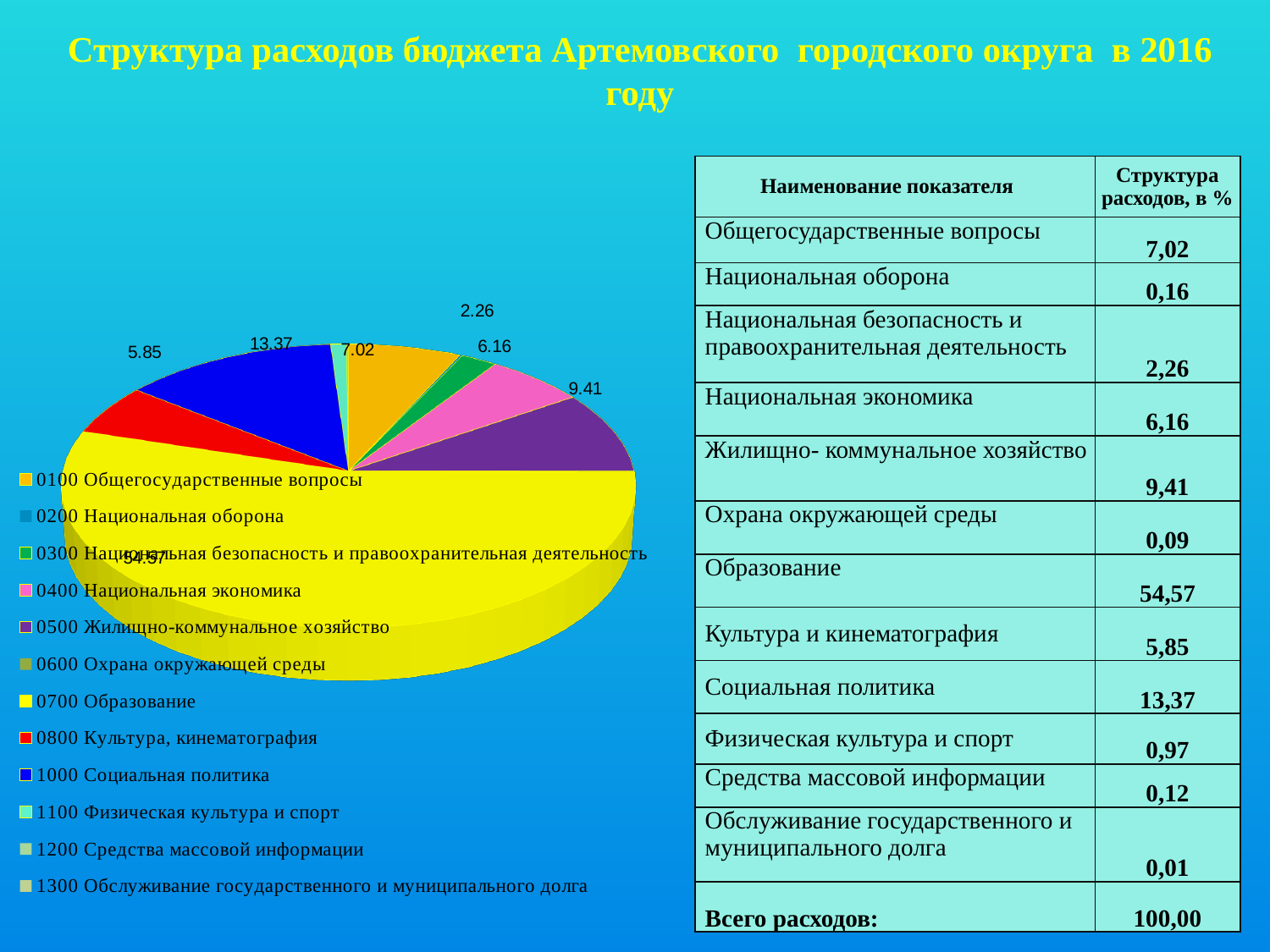
What value is labelled on the pie slice for 0500 Жилищно-коммунальное хозяйство? 9.41 What value is labelled on the pie slice for 0400 Национальная экономика? 6.16 Which category has the largest slice of the pie? 0700 Образование What is the difference between the labelled values for 0100 Общегосударственные вопросы and 0800 Культура, кинематография? 1.17 How many categories does the pie chart legend list? 12 What value is labelled on the pie slice for 0300 Национальная безопасность и правоохранительная деятельность? 2.26 What value is labelled on the pie slice for 1000 Социальная политика? 13.37 What colour is the slice for 0700 Образование? yellow Which slice is larger: 0400 Национальная экономика or 0800 Культура, кинематография? 0400 Национальная экономика What value is labelled on the pie slice for 0100 Общегосударственные вопросы? 7.02 What kind of chart is shown on the slide? pie chart What is the difference between the labelled values for 1000 Социальная политика and 0500 Жилищно-коммунальное хозяйство? 3.96